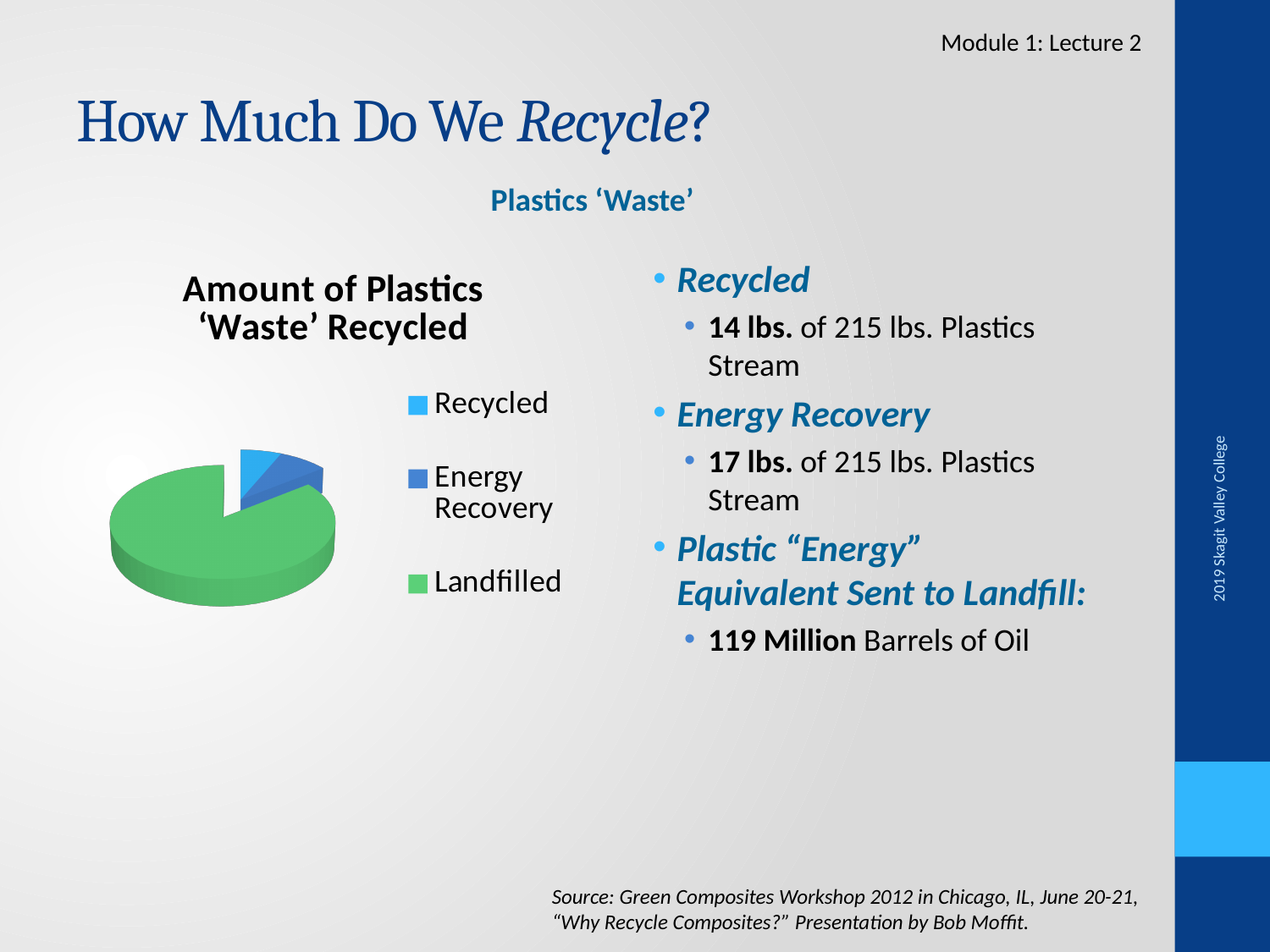
Does the Landfilled slice make up more or less than half of the pie chart? more What kind of chart is shown on the slide? pie chart What is the title of the pie chart? Amount of Plastics 'Waste' Recycled What colour is the Landfilled slice in the pie chart? green Which slice is larger in the pie chart, Landfilled or Energy Recovery? Landfilled Which slice is larger in the pie chart, Landfilled or Recycled? Landfilled How many entries does the pie chart's legend list? 3 Which category has the largest slice in the pie chart? Landfilled How many slices does the pie chart have? 3